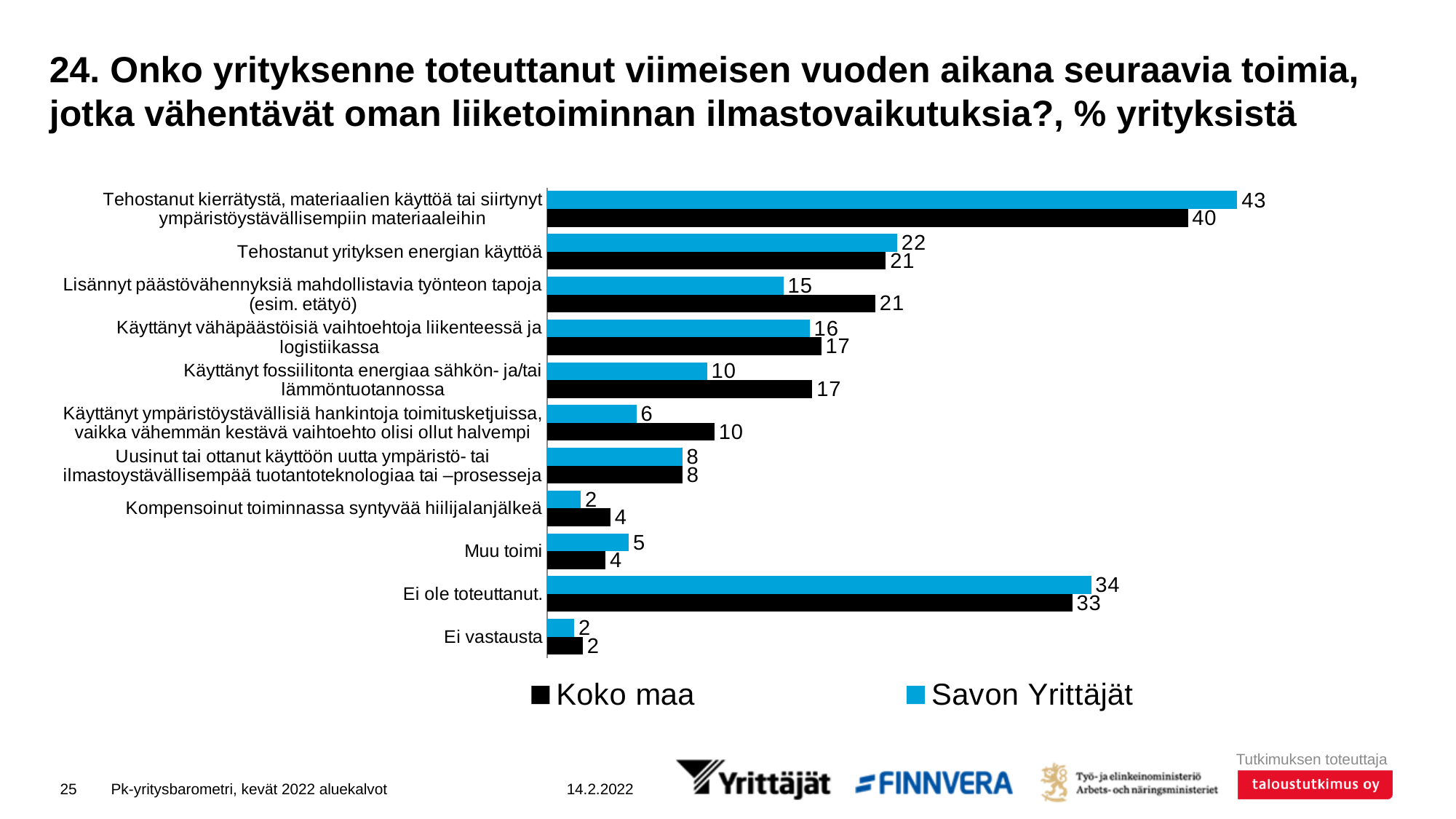
What is the value for Savon Yrittäjät for 'Tehostanut kierrätystä, materiaalien käyttöä tai siirtynyt ympäristöystävällisempiin materiaaleihin'? 43 What kind of chart is shown on the slide? bar chart How many series does the legend list? 2 What is the difference between Koko maa and Savon Yrittäjät for 'Käyttänyt fossiilitonta energiaa sähkön- ja/tai lämmöntuotannossa'? 7 What is the value for Savon Yrittäjät for 'Muu toimi'? 5 What is the value for Koko maa for 'Ei ole toteuttanut.'? 33 What is the value for Koko maa for 'Lisännyt päästövähennyksiä mahdollistavia työnteon tapoja (esim. etätyö)'? 21 Which category has the lowest value for Savon Yrittäjät, apart from 'Ei vastausta'? Kompensoinut toiminnassa syntyvää hiilijalanjälkeä How many categories are shown on the chart? 11 For 'Käyttänyt ympäristöystävällisiä hankintoja toimitusketjuissa, vaikka vähemmän kestävä vaihtoehto olisi ollut halvempi', which series has the larger value, Koko maa or Savon Yrittäjät? Koko maa Which colour represents Savon Yrittäjät in the chart? blue Which category has the highest value for Koko maa? Tehostanut kierrätystä, materiaalien käyttöä tai siirtynyt ympäristöystävällisempiin materiaaleihin